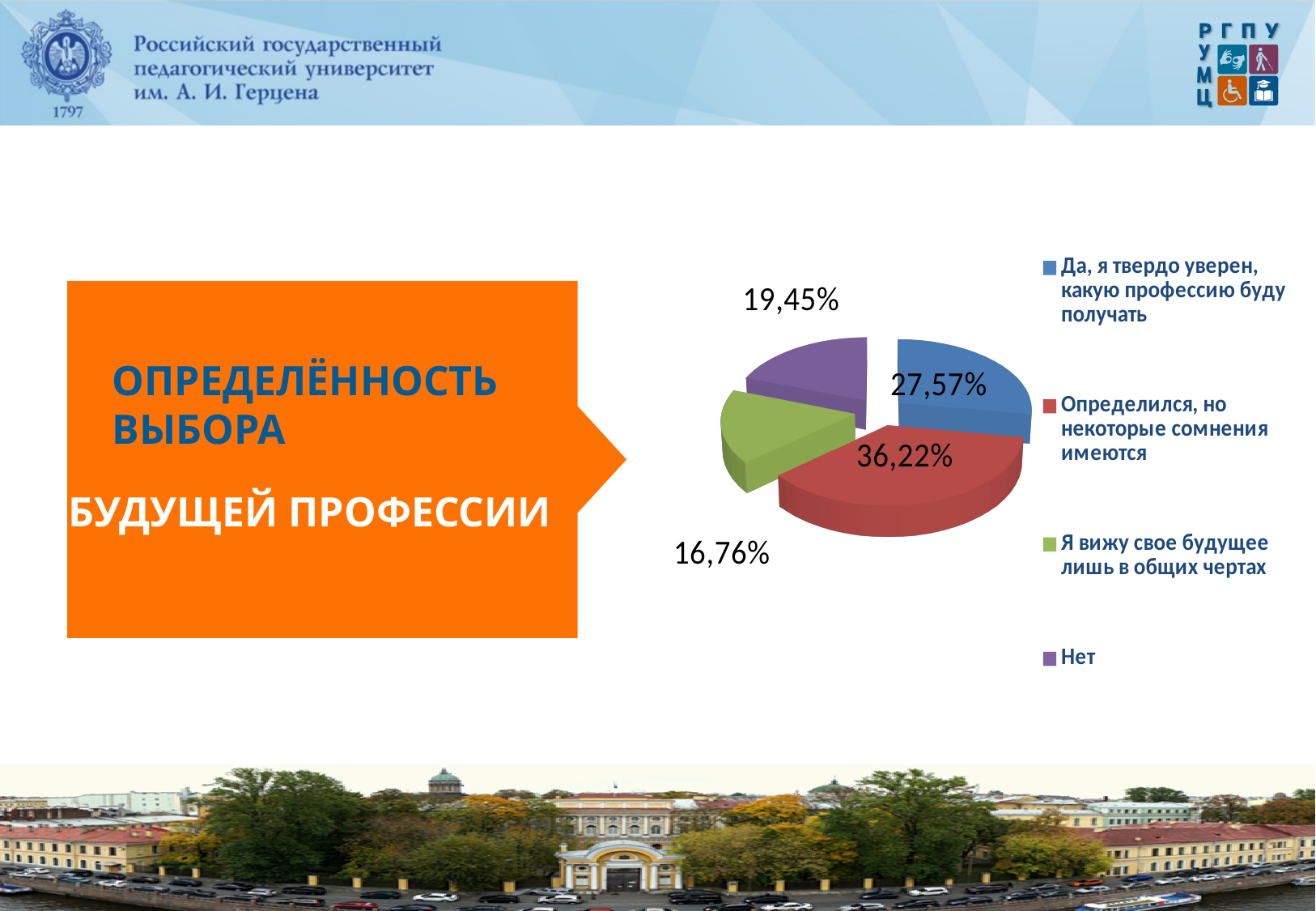
Which is larger: the share for "Нет" or the share for "Я вижу свое будущее лишь в общих чертах"? Нет What share of respondents answered "Определился, но некоторые сомнения имеются"? 36,22% What kind of chart is shown on the slide? Pie chart How many slices does the pie chart have? 4 What share of respondents answered "Нет"? 19,45% What share of respondents answered "Я вижу свое будущее лишь в общих чертах"? 16,76% What is the difference in percentage points between "Определился, но некоторые сомнения имеются" and "Да, я твердо уверен, какую профессию буду получать"? 8,65 Which answer option has the smallest share of the pie? Я вижу свое будущее лишь в общих чертах What share of respondents answered "Да, я твердо уверен, какую профессию буду получать"? 27,57% How many entries does the legend list? 4 Which answer option has the largest share of the pie? Определился, но некоторые сомнения имеются What colour is the slice for "Нет"? Purple